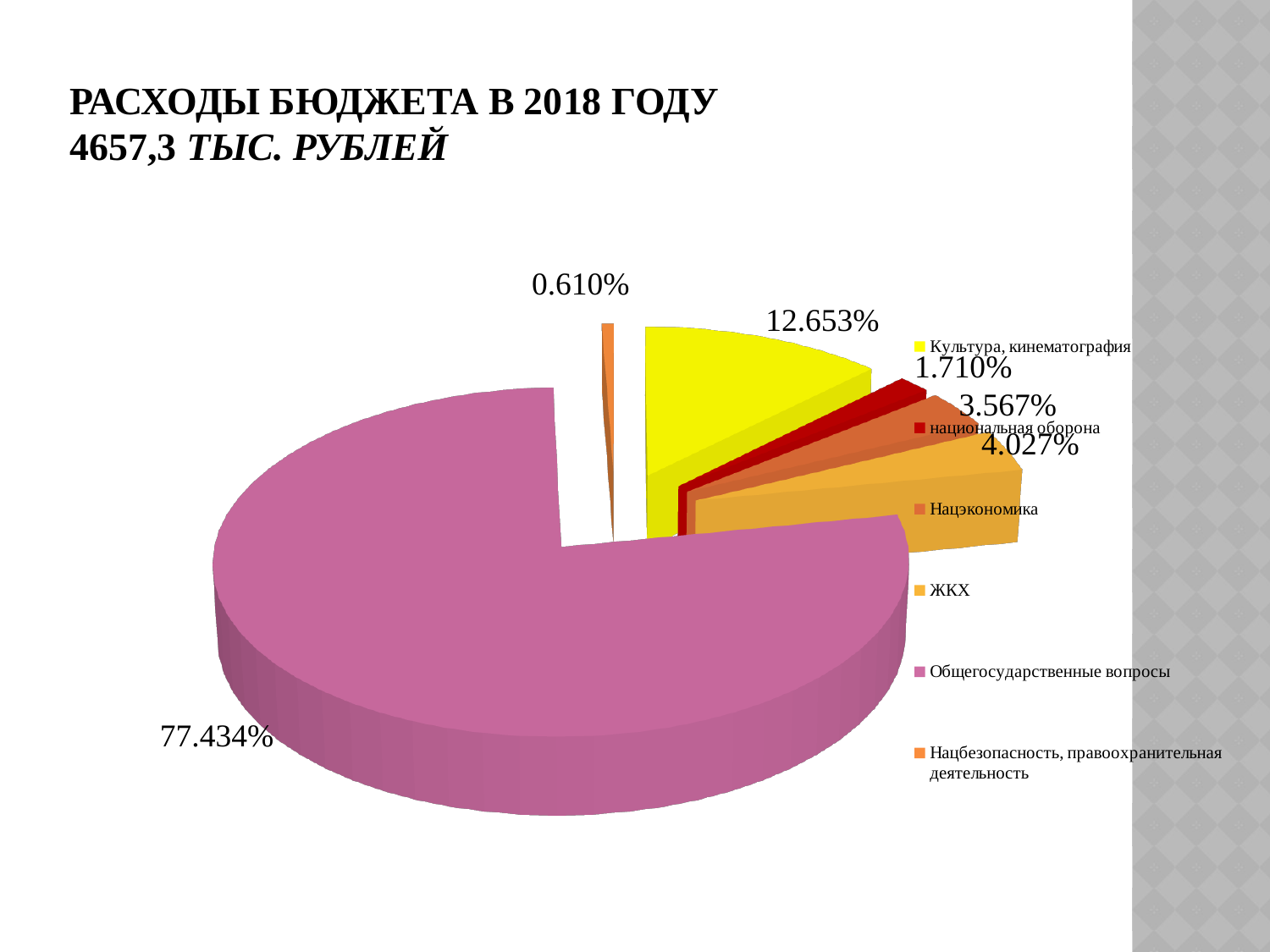
What is the value shown for Нацэкономика? 3.567% How many categories does the legend of the pie chart list? 6 What is the value shown for национальная оборона? 1.710% What share of the pie does Общегосударственные вопросы take? 77.434% What is the title of the chart on the slide? РАСХОДЫ БЮДЖЕТА В 2018 ГОДУ 4657,3 ТЫС. РУБЛЕЙ Which is larger, the slice for ЖКХ or the slice for Нацэкономика? ЖКХ Which category has the smallest slice of the pie? Нацбезопасность, правоохранительная деятельность Which category has the largest slice of the pie? Общегосударственные вопросы What is the difference between the share for Культура, кинематография and the share for ЖКХ? 8.626% What is the value shown for ЖКХ? 4.027% What kind of chart is shown on the slide? pie chart What share of the pie does Культура, кинематография take? 12.653%